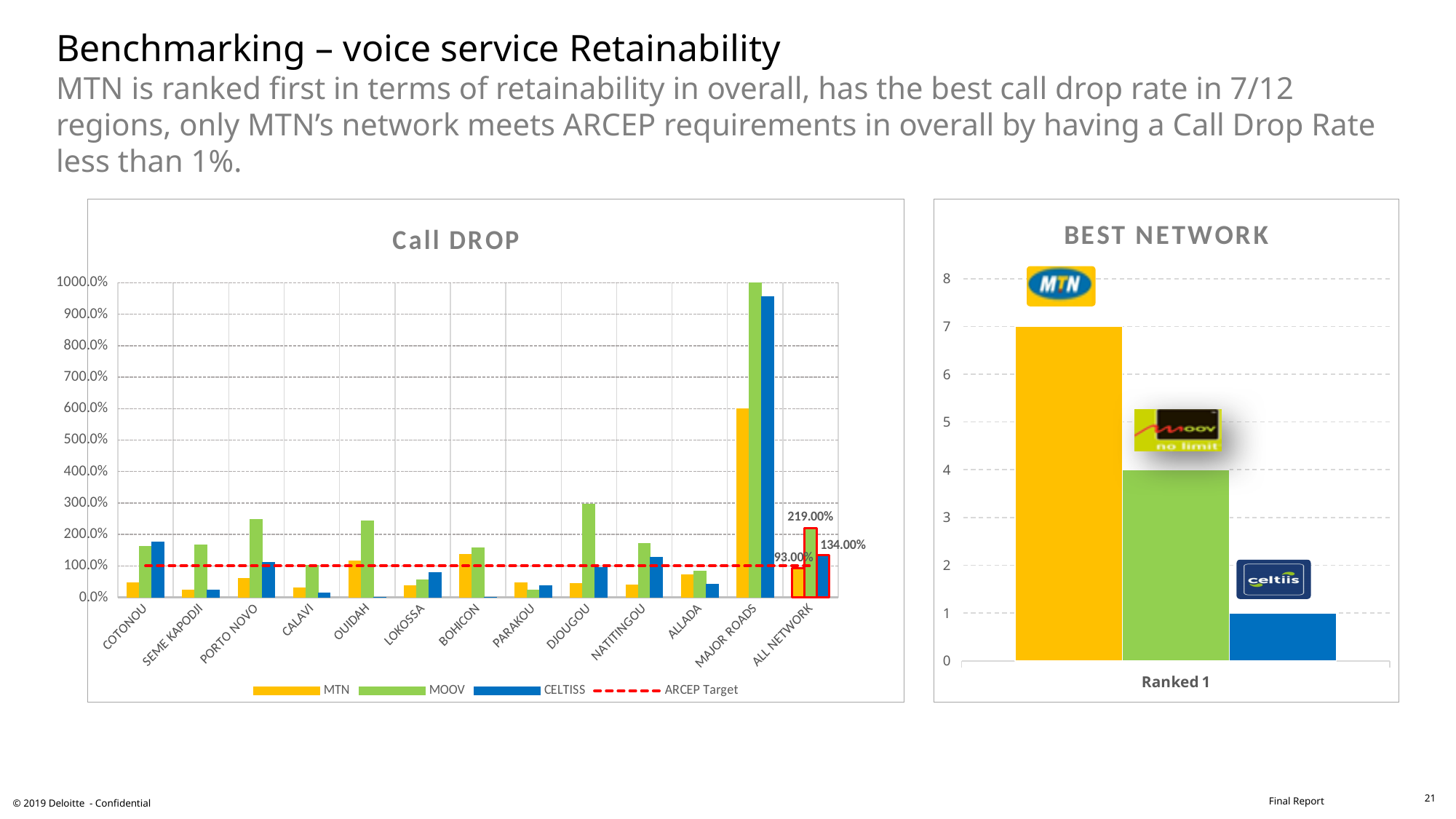
In the Call DROP chart, which operator has the highest value for ALL NETWORK? MOOV In the Call DROP chart, what is the MOOV value for ALL NETWORK? 219.00% In the Call DROP chart, what is the difference between the MOOV and MTN values for ALL NETWORK? 126.00% In the Call DROP chart, what is the MTN value for ALL NETWORK? 93.00% What kind of chart is the BEST NETWORK chart? bar chart In the BEST NETWORK chart, what is the value of the MTN bar? 7 In the Call DROP chart, is the MOOV value for MAJOR ROADS greater or less than 900.0%? greater How many categories are shown on the x axis of the Call DROP chart? 13 In the Call DROP chart, what is the CELTISS value for ALL NETWORK? 134.00% In the BEST NETWORK chart, which operator has the lowest bar? Celtiis How many entries does the legend of the Call DROP chart list? 4 In the Call DROP chart, is the MTN value for COTONOU greater or less than 100.0%? less